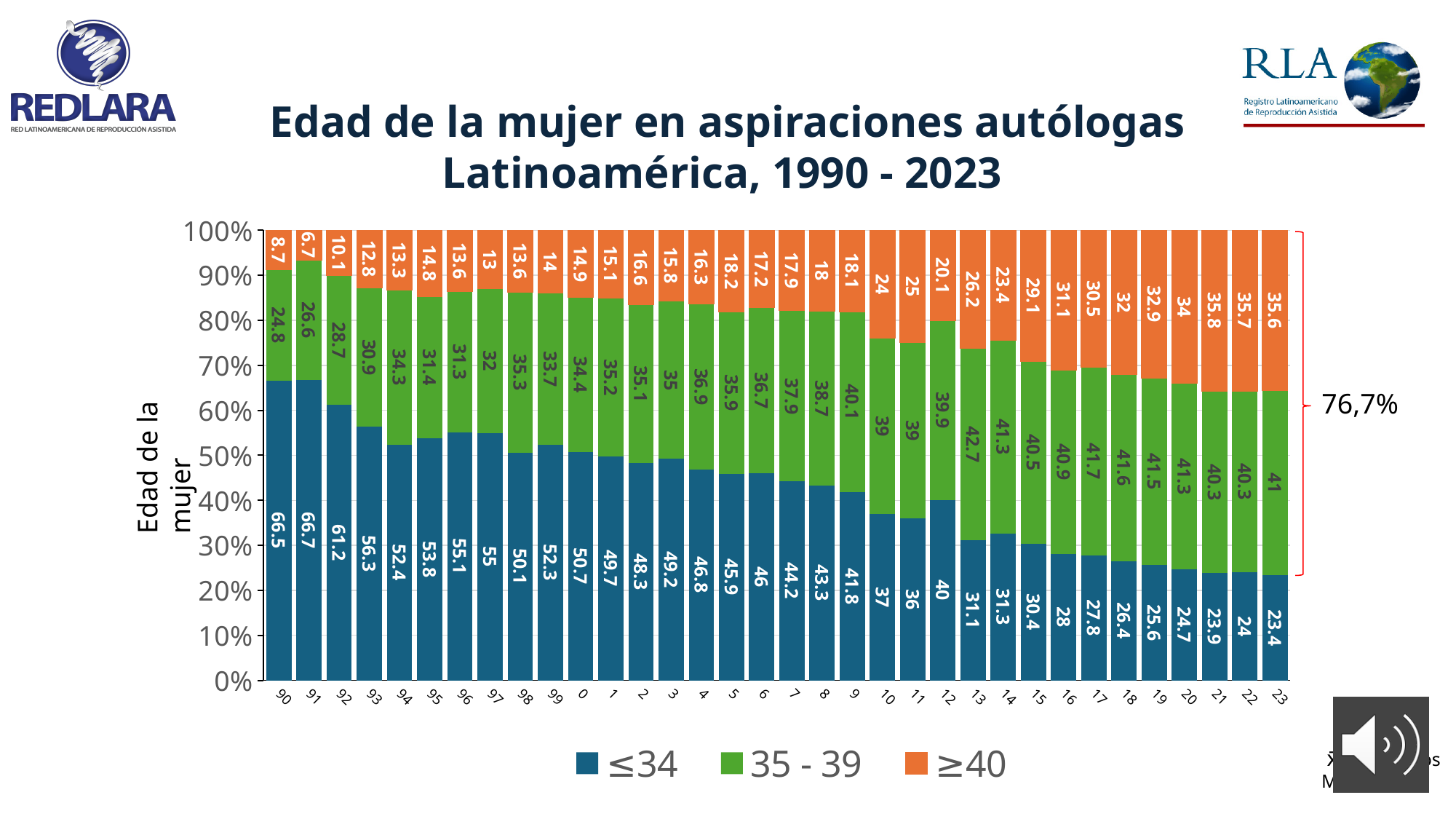
Does the ≤34 series generally rise or fall from 1990 to 2023? Fall What kind of chart is shown on the slide? Stacked bar chart What is the value for the ≤34 series in 1990 (label 90)? 66.5 Which is larger in 2010 (label 10): the ≤34 value or the 35 - 39 value? 35 - 39 In which year is the ≥40 series lowest? 1991 (label 91) What is the value for the 35 - 39 series in 2012 (label 12)? 39.9 What is the difference between the ≤34 value in 1990 (66.5) and in 2023 (23.4)? 43.1 What is the value for the ≥40 series in 2023 (label 23)? 35.6 What is the title of the chart? Edad de la mujer en aspiraciones autólogas Latinoamérica, 1990 - 2023 In which year is the ≤34 series highest? 1991 (label 91) How many years (bars) are plotted on the x axis? 34 How many series does the legend list? 3